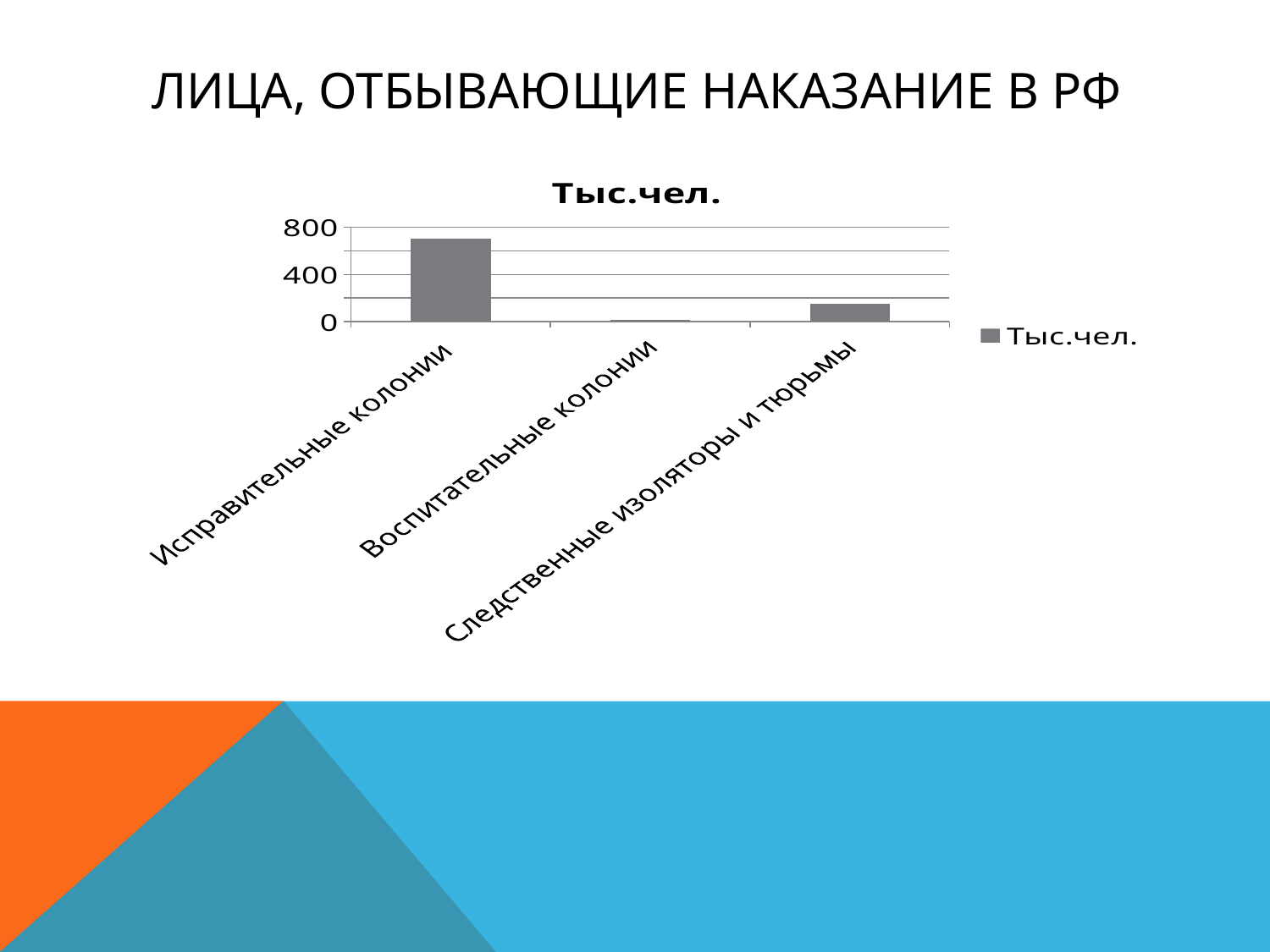
What is the title of the chart? Тыс.чел. Is the value for Следственные изоляторы и тюрьмы greater or less than 400? less Which is larger: the value for Исправительные колонии or the value for Следственные изоляторы и тюрьмы? Исправительные колонии Is the value for Исправительные колонии greater or less than 400? greater How many series does the chart legend list? 1 How many categories are shown on the x axis of the chart? 3 Is the value for Воспитательные колонии greater or less than 400? less What kind of chart is shown on the slide? bar chart Which is larger: the value for Следственные изоляторы и тюрьмы or the value for Воспитательные колонии? Следственные изоляторы и тюрьмы Which category has the highest value in the chart? Исправительные колонии What is the name of the series listed in the chart legend? Тыс.чел. Which category has the lowest value in the chart? Воспитательные колонии